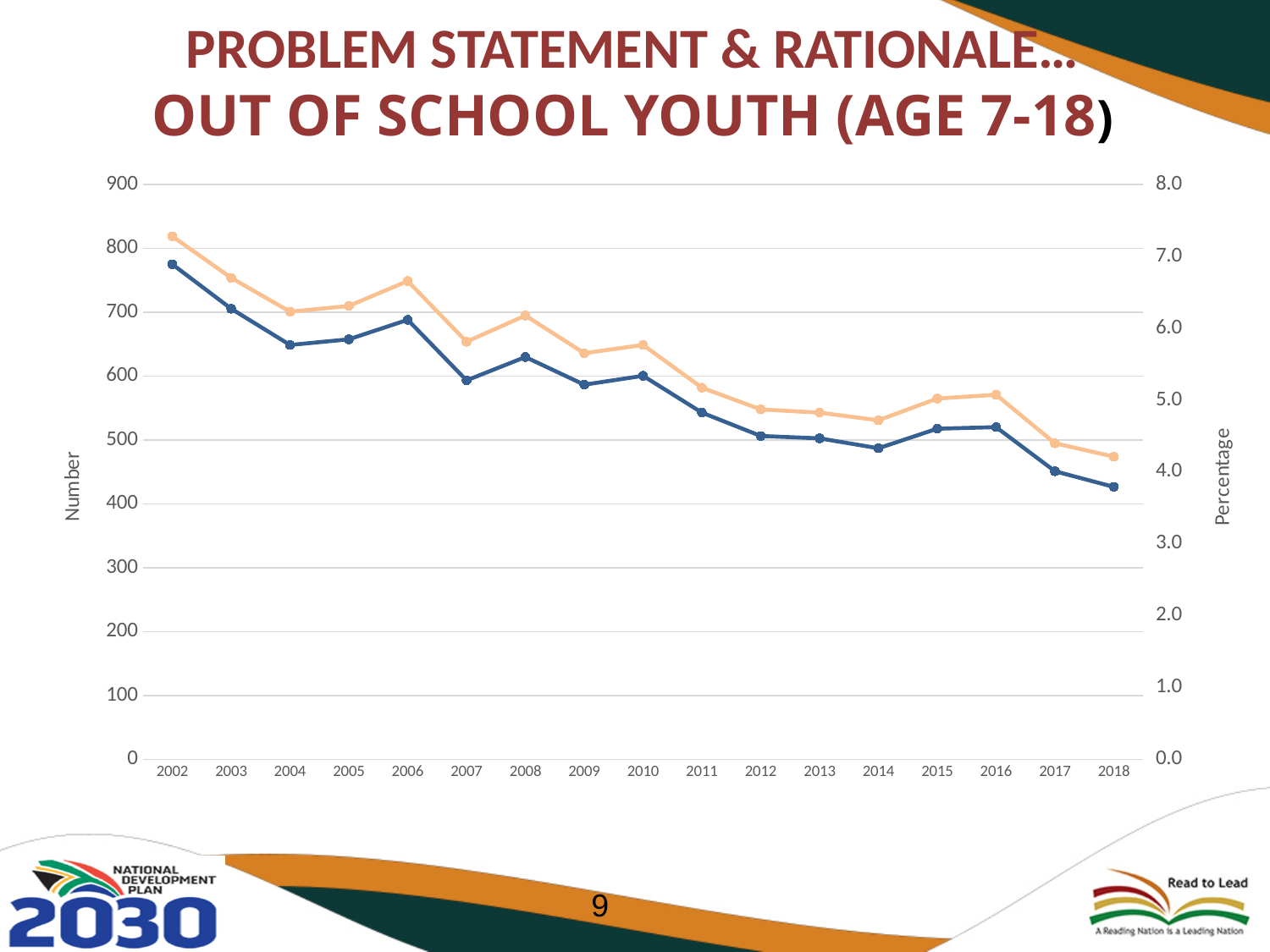
Do the plotted lines generally rise or fall from 2002 to 2018? fall How many years are plotted along the x axis? 17 What kind of chart is shown on the slide? line chart Read against the left axis, is the value of the orange line in 2018 greater or less than 500? less Read against the left axis, is the value of the blue line in 2002 greater or less than 700? greater In which year does the blue line reach its highest point? 2002 Read against the left axis, is the value of the blue line in 2018 greater or less than 500? less For the blue line, which year has the larger value, 2006 or 2007? 2006 What is the title of the left vertical axis? Number In which year does the blue line reach its lowest point? 2018 What is the title of the right vertical axis? Percentage For the orange line, which year has the larger value, 2014 or 2016? 2016